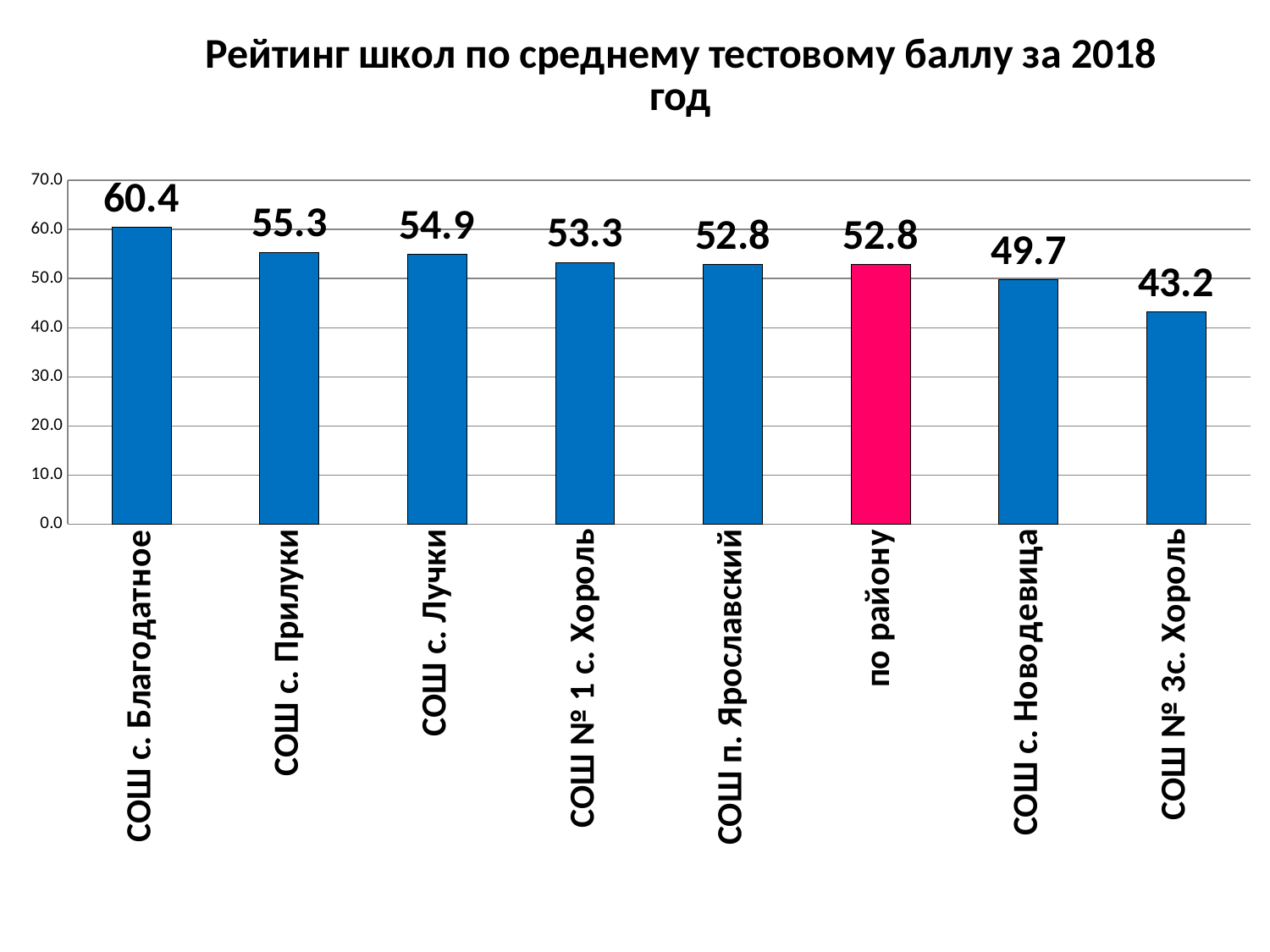
Which category has the highest value? СОШ с. Благодатное What is the value for СОШ с. Благодатное? 60.4 What kind of chart is shown on the slide? bar chart What is the difference between the values for СОШ с. Благодатное and СОШ № 3с. Хороль? 17.2 Which bar is coloured differently from the others? по району How many categories are shown on the chart? 8 Is the value for СОШ № 3с. Хороль greater or less than 50.0? less What is the value for по району? 52.8 Which is larger, the value for СОШ № 1 с. Хороль or the value for СОШ с. Новодевица? СОШ № 1 с. Хороль What is the value for СОШ с. Новодевица? 49.7 What is the difference between the values for СОШ с. Прилуки and СОШ с. Лучки? 0.4 Which category has the lowest value? СОШ № 3с. Хороль